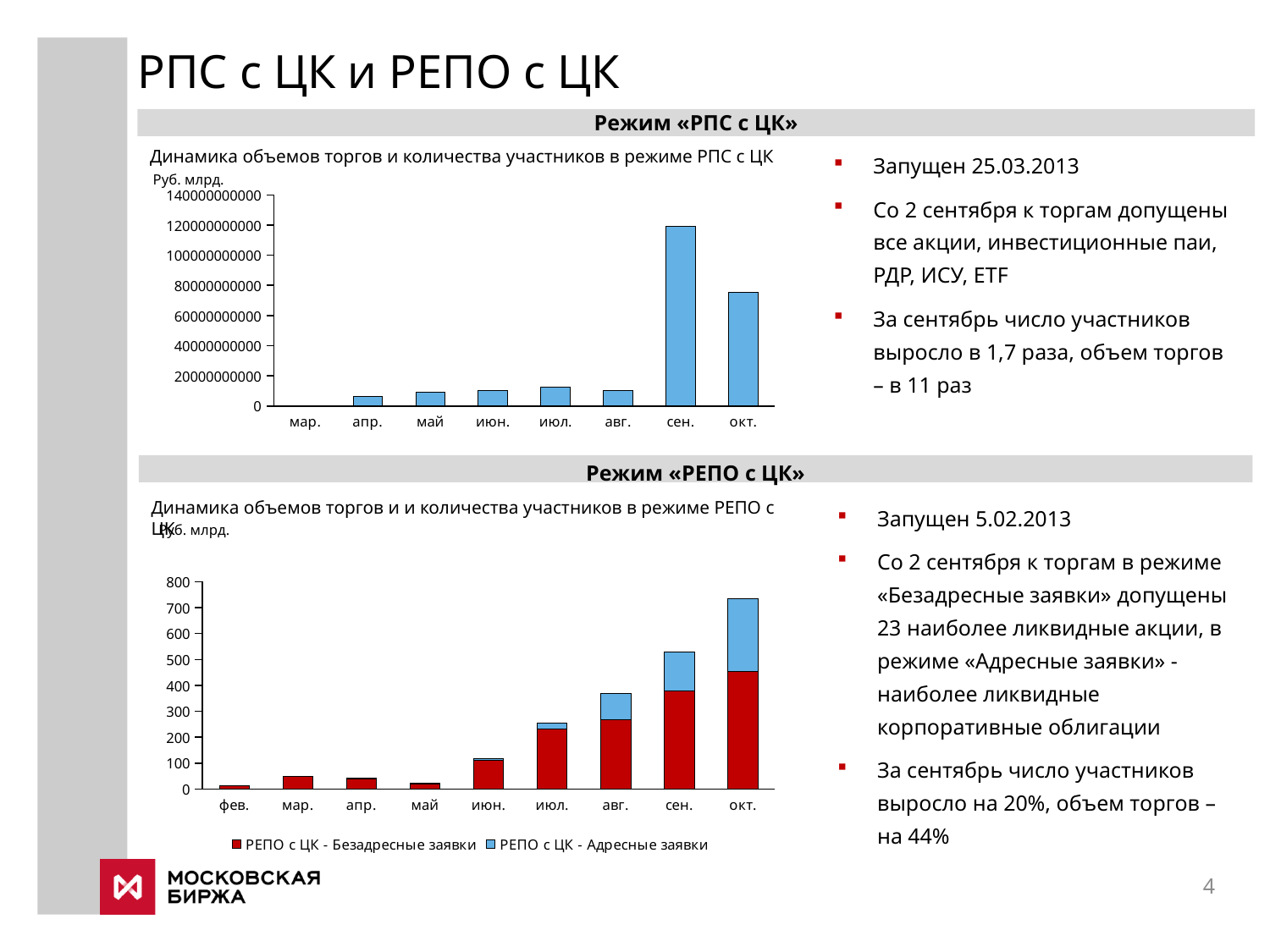
In the top chart (режим РПС с ЦК), is the value for авг. greater or less than 20000000000? less In the bottom chart (режим РЕПО с ЦК), how many months are shown on the x axis? 9 In the top chart (режим РПС с ЦК), is the value for сен. greater or less than 100000000000? greater In the bottom chart (режим РЕПО с ЦК), how many series does the legend list? 2 In the top chart (режим РПС с ЦК), which month has the highest trading volume? сен. In the bottom chart (режим РЕПО с ЦК), which series is shown in red? РЕПО с ЦК - Безадресные заявки In the bottom chart (режим РЕПО с ЦК), is the total for окт. greater or less than 700? greater What kind of chart is the top chart, 'Динамика объемов торгов и количества участников в режиме РПС с ЦК'? bar chart In the top chart (режим РПС с ЦК), which is larger, the value for сен. or the value for окт.? сен. What kind of chart is the bottom chart, 'Динамика объемов торгов и количества участников в режиме РЕПО с ЦК'? stacked bar chart In the bottom chart (режим РЕПО с ЦК), which month has the highest total bar? окт. In the top chart (режим РПС с ЦК), how many months are shown on the x axis? 8